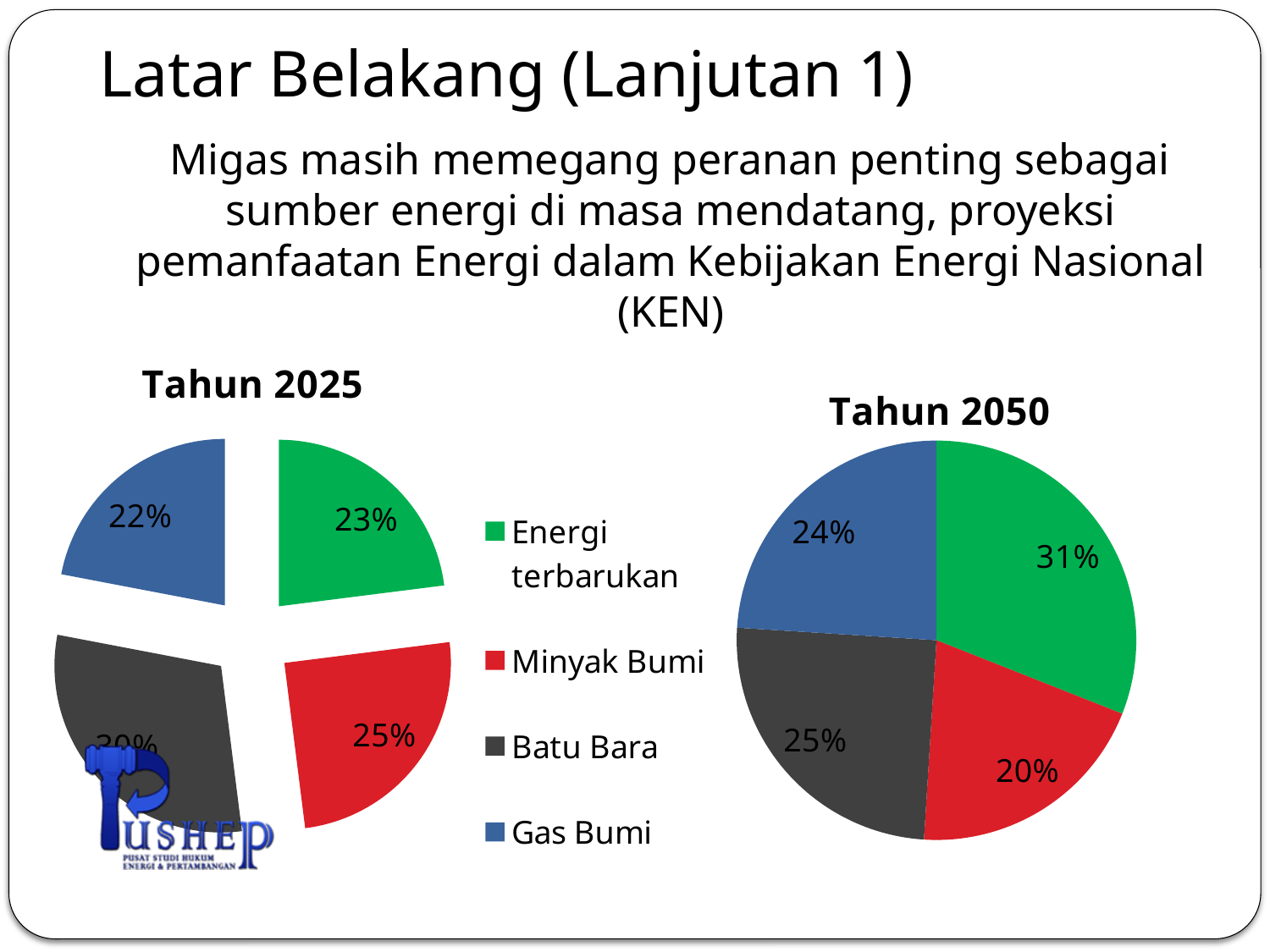
What is the difference between the Energi terbarukan share in the Tahun 2050 chart and in the Tahun 2025 chart? 8% In the Tahun 2050 pie chart, what share does Energi terbarukan have? 31% In the Tahun 2025 pie chart, which is larger: Energi terbarukan or Gas Bumi? Energi terbarukan In the Tahun 2050 pie chart, what share does Batu Bara have? 25% What type of chart is used for Tahun 2025 and Tahun 2050? Pie chart In the Tahun 2050 pie chart, which category has the smallest share? Minyak Bumi Which colour represents Batu Bara in the pie charts? Dark gray In the Tahun 2025 pie chart, what share does Gas Bumi have? 22% In the Tahun 2050 pie chart, what share does Minyak Bumi have? 20% In the Tahun 2050 pie chart, which category has the largest share? Energi terbarukan How many categories does the legend list for the pie charts? 4 In the Tahun 2025 pie chart, what share does Minyak Bumi have? 25%